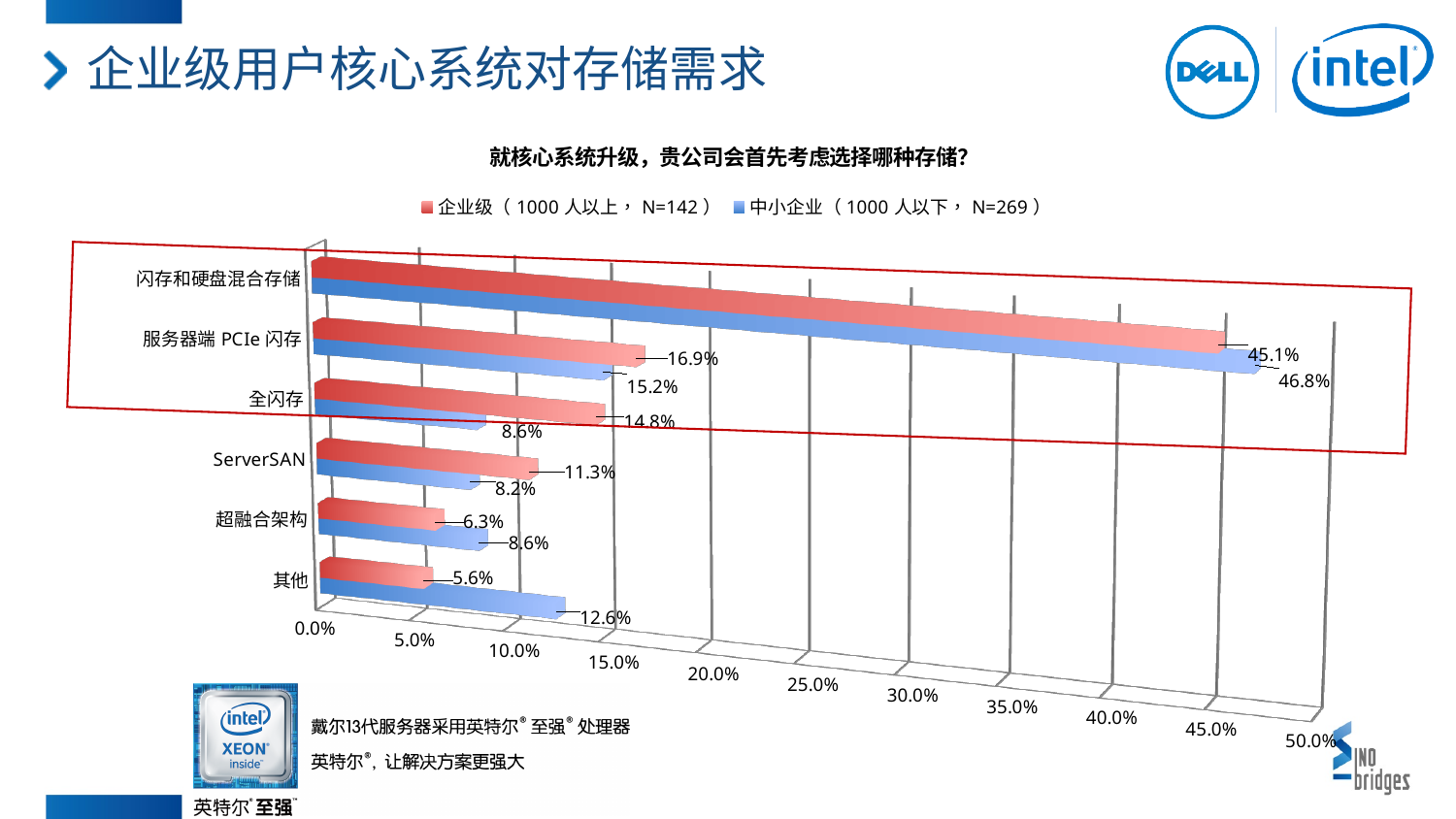
How many categories are shown on the chart? 6 What kind of chart is shown on the slide? Bar chart What is the value for 中小企业 (1000人以下, N=269) for 其他? 12.6% What is the value for 企业级 (1000人以上, N=142) for 服务器端 PCIe 闪存? 16.9% Which category has the lowest value for 企业级 (1000人以上, N=142)? 其他 For ServerSAN, which series has the larger value, 企业级 or 中小企业? 企业级 Which category has the highest value for 企业级 (1000人以上, N=142)? 闪存和硬盘混合存储 What is the value for 中小企业 (1000人以下, N=269) for 闪存和硬盘混合存储? 46.8% What is the value for 企业级 (1000人以上, N=142) for 闪存和硬盘混合存储? 45.1% For 超融合架构, which series has the larger value, 企业级 or 中小企业? 中小企业 How many series does the legend list? 2 What is the difference between the 企业级 and 中小企业 values for 全闪存? 6.2%